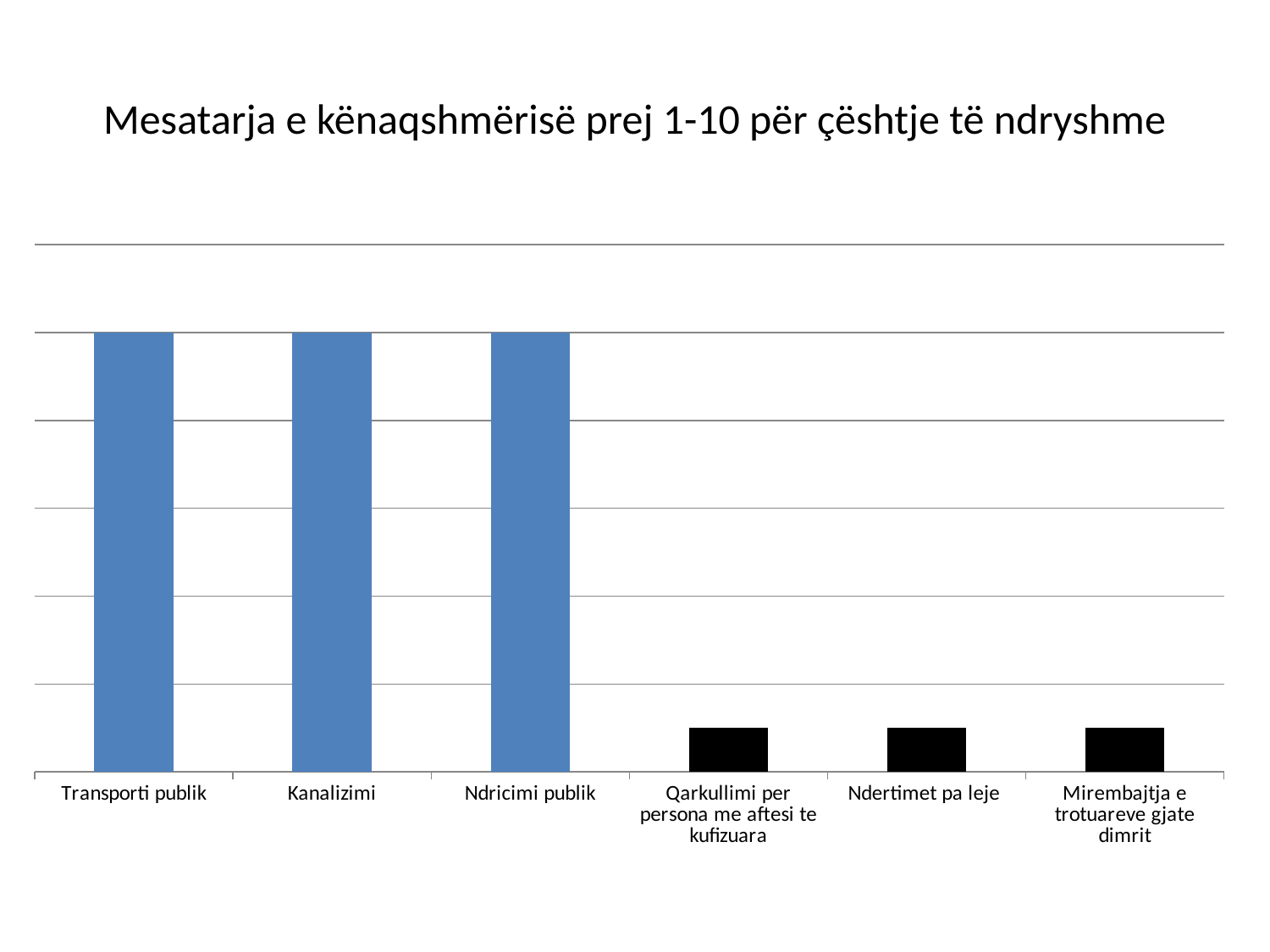
What is the title of the chart? Mesatarja e kënaqshmërisë prej 1-10 për çështje të ndryshme Which has the larger value, Kanalizimi or Qarkullimi per persona me aftesi te kufizuara? Kanalizimi Which has the larger value, Transporti publik or Ndertimet pa leje? Transporti publik Which has the smaller value, Ndricimi publik or Ndertimet pa leje? Ndertimet pa leje What colour are the bars for Transporti publik, Kanalizimi and Ndricimi publik? blue How many bars in the chart are black? 3 How many categories are shown on the x axis of the chart? 6 What kind of chart is shown on the slide? bar chart